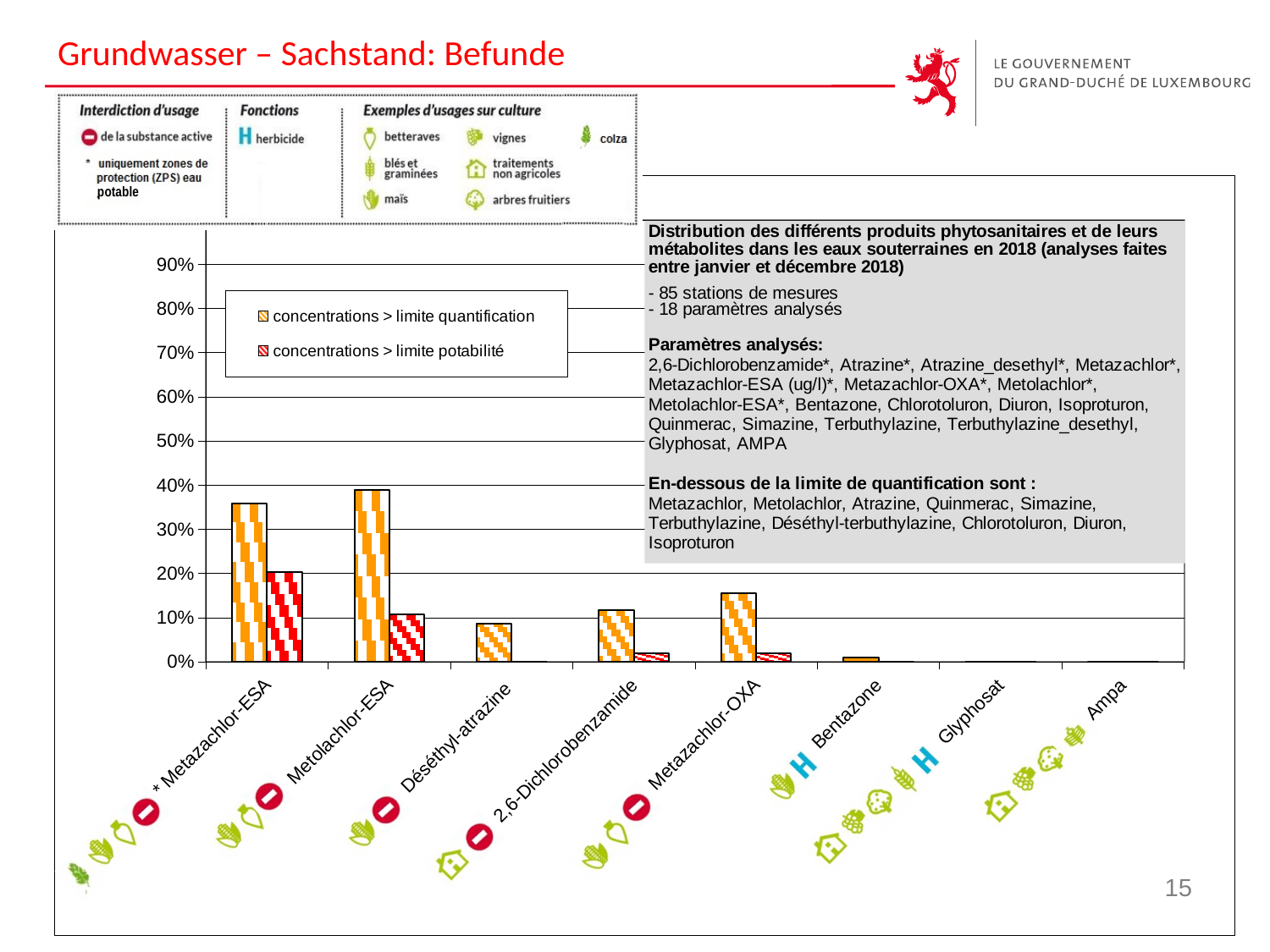
Is the 'concentrations > limite quantification' value for Déséthyl-atrazine greater or less than 10%? less Which legend entry is shown with the orange pattern in the chart? concentrations > limite quantification Which has the larger 'concentrations > limite potabilité' value: * Metazachlor-ESA or Metolachlor-ESA? * Metazachlor-ESA Which substance has the highest bar for 'concentrations > limite quantification'? Metolachlor-ESA How many series does the chart legend list? 2 What kind of chart is shown on the slide? bar chart Which has the larger 'concentrations > limite quantification' value: Metazachlor-OXA or 2,6-Dichlorobenzamide? Metazachlor-OXA Is the 'concentrations > limite quantification' value for Metazachlor-OXA greater or less than 10%? greater Is the 'concentrations > limite quantification' value for * Metazachlor-ESA greater or less than 30%? greater How many substances (categories) are shown along the x axis of the chart? 8 Which substance has the highest bar for 'concentrations > limite potabilité'? * Metazachlor-ESA